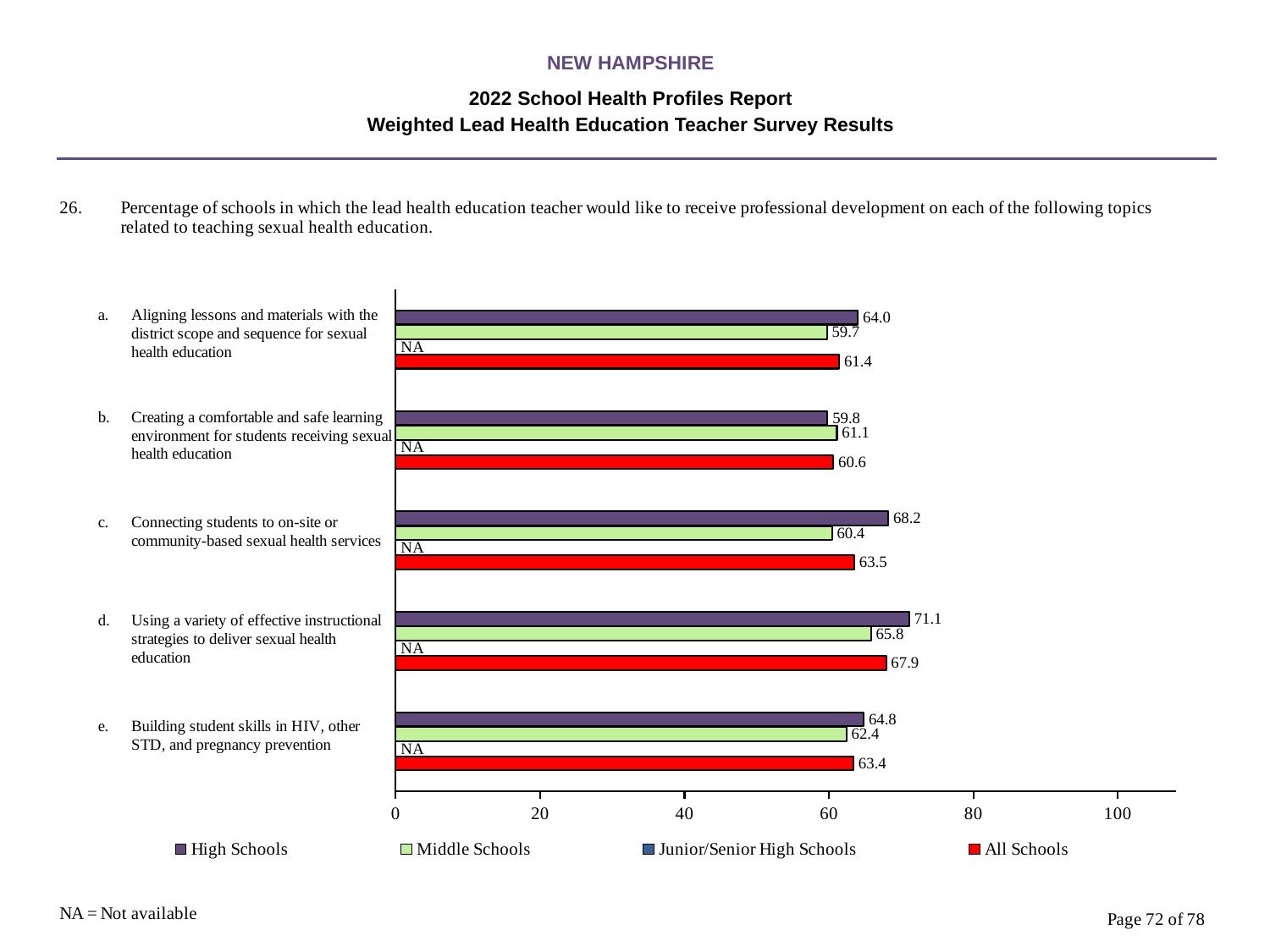
What is the All Schools value for 'Connecting students to on-site or community-based sexual health services'? 63.5 What is the Middle Schools value for 'Building student skills in HIV, other STD, and pregnancy prevention'? 62.4 What is the difference between the High Schools and Middle Schools values for 'Connecting students to on-site or community-based sexual health services'? 7.8 What is the High Schools value for 'Using a variety of effective instructional strategies to deliver sexual health education'? 71.1 What kind of chart is shown on the slide? bar chart Is the All Schools value for 'Using a variety of effective instructional strategies to deliver sexual health education' greater or less than 60? greater What is shown for Junior/Senior High Schools for 'Creating a comfortable and safe learning environment for students receiving sexual health education'? NA How many topics are listed on the chart? 5 How many series does the legend list? 4 For 'Creating a comfortable and safe learning environment for students receiving sexual health education', which is larger: the High Schools value or the Middle Schools value? Middle Schools Which topic has the lowest All Schools value? Creating a comfortable and safe learning environment for students receiving sexual health education Which topic has the highest High Schools value? Using a variety of effective instructional strategies to deliver sexual health education